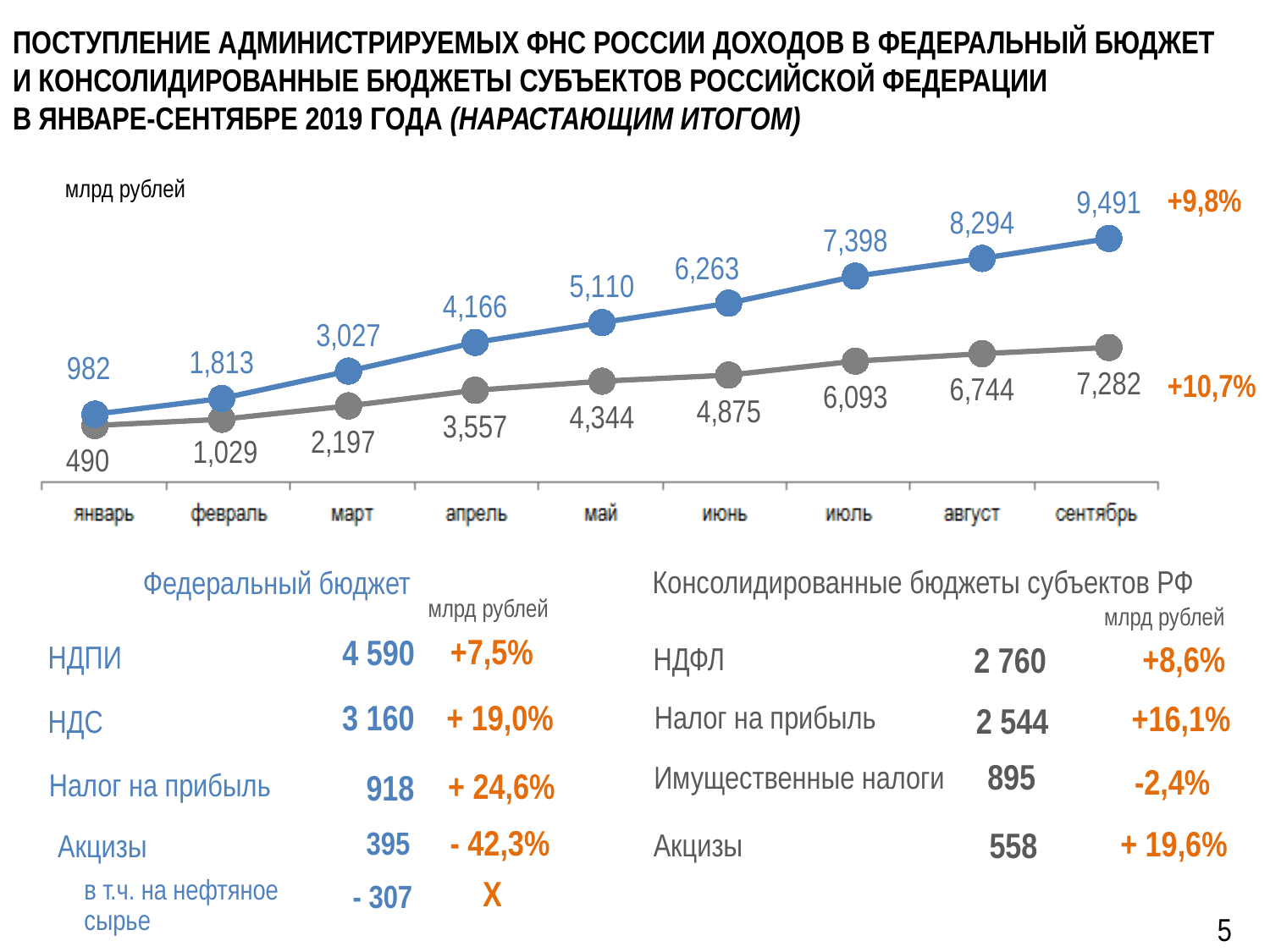
What type of chart is shown on the slide? line chart What is the value of the grey line for январь? 490 What is the value of the blue line for сентябрь? 9,491 What is the difference between the blue line and the grey line in сентябрь? 2,209 In which month does the blue line reach its highest value? сентябрь Which line has the higher value in июль, the blue line or the grey line? the blue line What is the value of the grey line for май? 4,344 In which month is the grey line at its lowest value? январь How many months are plotted along the x axis of the chart? 9 Do the values of the blue line rise or fall from январь to сентябрь? rise How many lines (series) are plotted on the chart? 2 What is the value of the blue line for март? 3,027